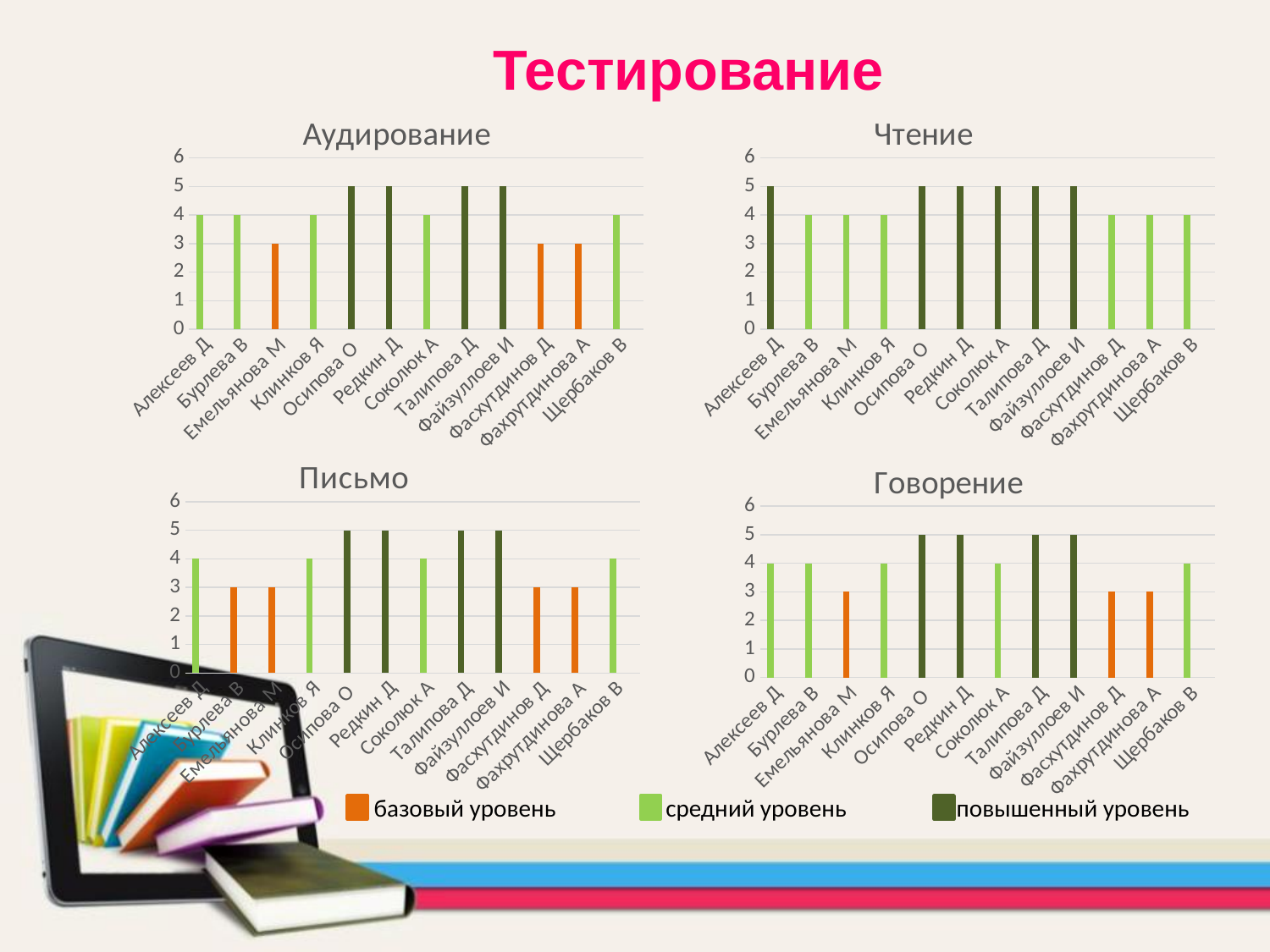
How many students are shown on the x axis of the Говорение chart? 12 In the Аудирование chart, what is the value for Осипова О? 5 In the Письмо chart, what is the difference between the values for Талипова Д and Фахрутдинова А? 2 In the Аудирование chart, which is larger, the value for Редкин Д or the value for Фасхутдинов Д? Редкин Д In the Говорение chart, what is the value for Емельянова М? 3 In the Чтение chart, is the value for Щербаков В greater or less than 5? less In the Письмо chart, what is the value for Бурлева В? 3 In the Чтение chart, what is the value for Алексеев Д? 5 What type of chart is the Чтение chart? bar chart In the Чтение chart, is the value for Соколюк А greater or less than 4? greater How many levels does the legend at the bottom of the slide list? 3 Which legend entry is shown in orange? базовый уровень